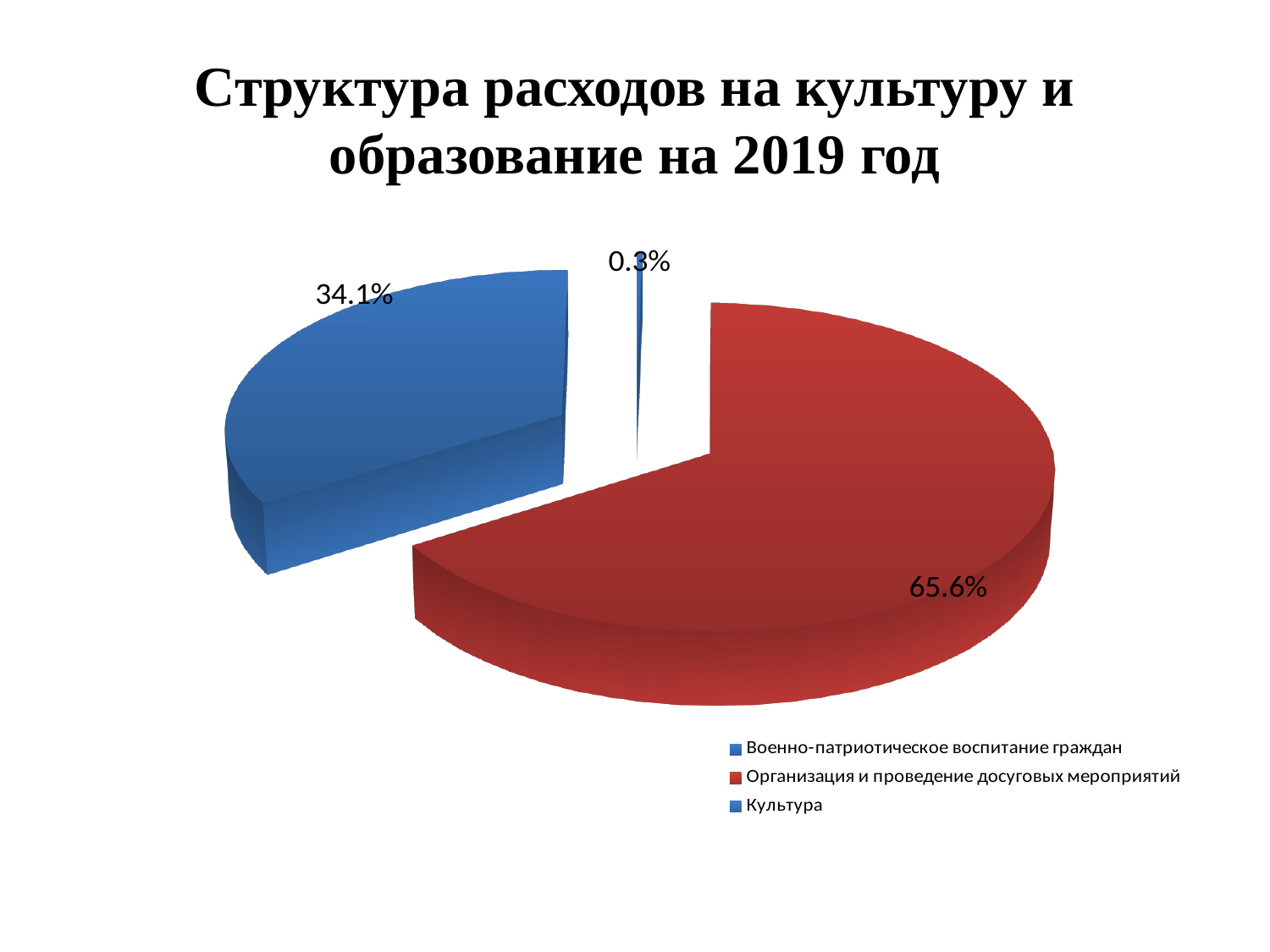
What percentage share does "Культура" have in the pie chart? 34.1% What is the difference in percentage points between the shares of "Организация и проведение досуговых мероприятий" and "Культура"? 31.5 Which category has the smallest share of the pie chart? Военно-патриотическое воспитание граждан What percentage share does "Организация и проведение досуговых мероприятий" have in the pie chart? 65.6% How many entries does the legend list? 3 What is the title of the chart on the slide? Структура расходов на культуру и образование на 2019 год What colour is the slice for "Организация и проведение досуговых мероприятий"? red Which category has the largest share of the pie chart? Организация и проведение досуговых мероприятий Which has a larger share: "Культура" or "Военно-патриотическое воспитание граждан"? Культура How many slices does the pie chart have? 3 What type of chart is shown on the slide? pie chart What percentage share does "Военно-патриотическое воспитание граждан" have in the pie chart? 0.3%